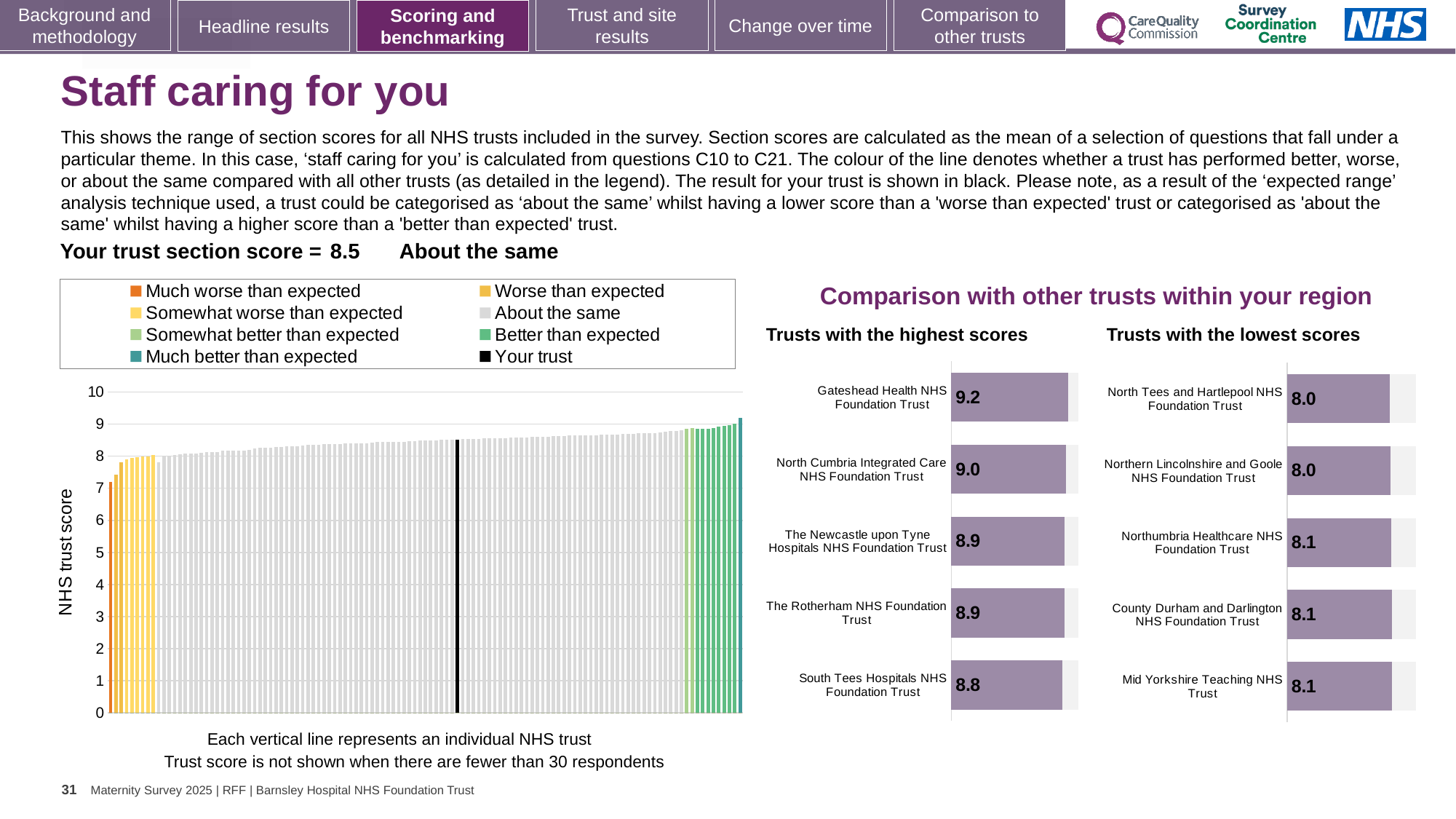
In the 'NHS trust score' chart on the left, what is the section score for your trust (the black bar)? 8.5 What kind of chart is the 'NHS trust score' chart on the left of the slide? bar chart In the 'NHS trust score' chart on the left, do the trust scores rise or fall from left to right? rise How many entries does the legend above the 'NHS trust score' chart list? 8 In the 'Trusts with the lowest scores' chart, what is the score for Mid Yorkshire Teaching NHS Trust? 8.1 In the 'Trusts with the highest scores' chart, which trust has the highest score? Gateshead Health NHS Foundation Trust In the 'Trusts with the highest scores' chart, what is the difference between the scores of Gateshead Health NHS Foundation Trust and South Tees Hospitals NHS Foundation Trust? 0.4 In the 'Trusts with the highest scores' chart, what is the score for South Tees Hospitals NHS Foundation Trust? 8.8 In the 'Trusts with the highest scores' chart, what is the score for Gateshead Health NHS Foundation Trust? 9.2 How many trusts are shown in the 'Trusts with the lowest scores' chart? 5 In the 'Trusts with the lowest scores' chart, what is the score for Northumbria Healthcare NHS Foundation Trust? 8.1 In the 'Trusts with the highest scores' chart, which has the larger score: North Cumbria Integrated Care NHS Foundation Trust or The Rotherham NHS Foundation Trust? North Cumbria Integrated Care NHS Foundation Trust